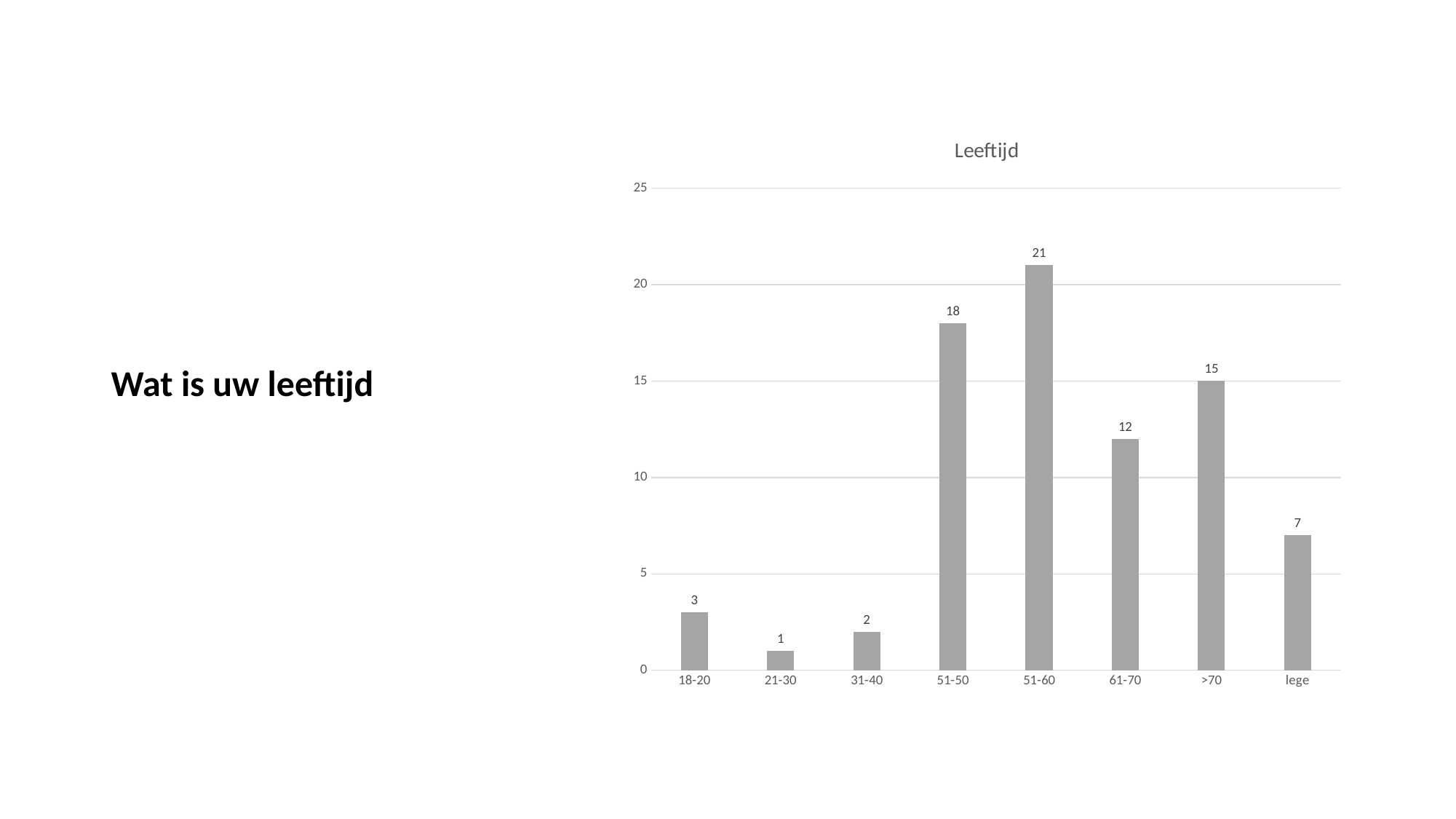
What is the value for the 'lege' category? 7 What is the difference between the values for >70 and 31-40? 13 Which category has the lowest value? 21-30 Which is larger, the value for 51-50 or the value for >70? 51-50 How many categories are shown on the x axis? 8 What is the value for the 18-20 category? 3 What is the value for the 51-60 category? 21 What is the title of the chart? Leeftijd Which category has the highest value? 51-60 Is the value for 61-70 greater or less than 10? greater What is the difference between the values for 51-60 and 61-70? 9 What kind of chart is shown on the slide? bar chart